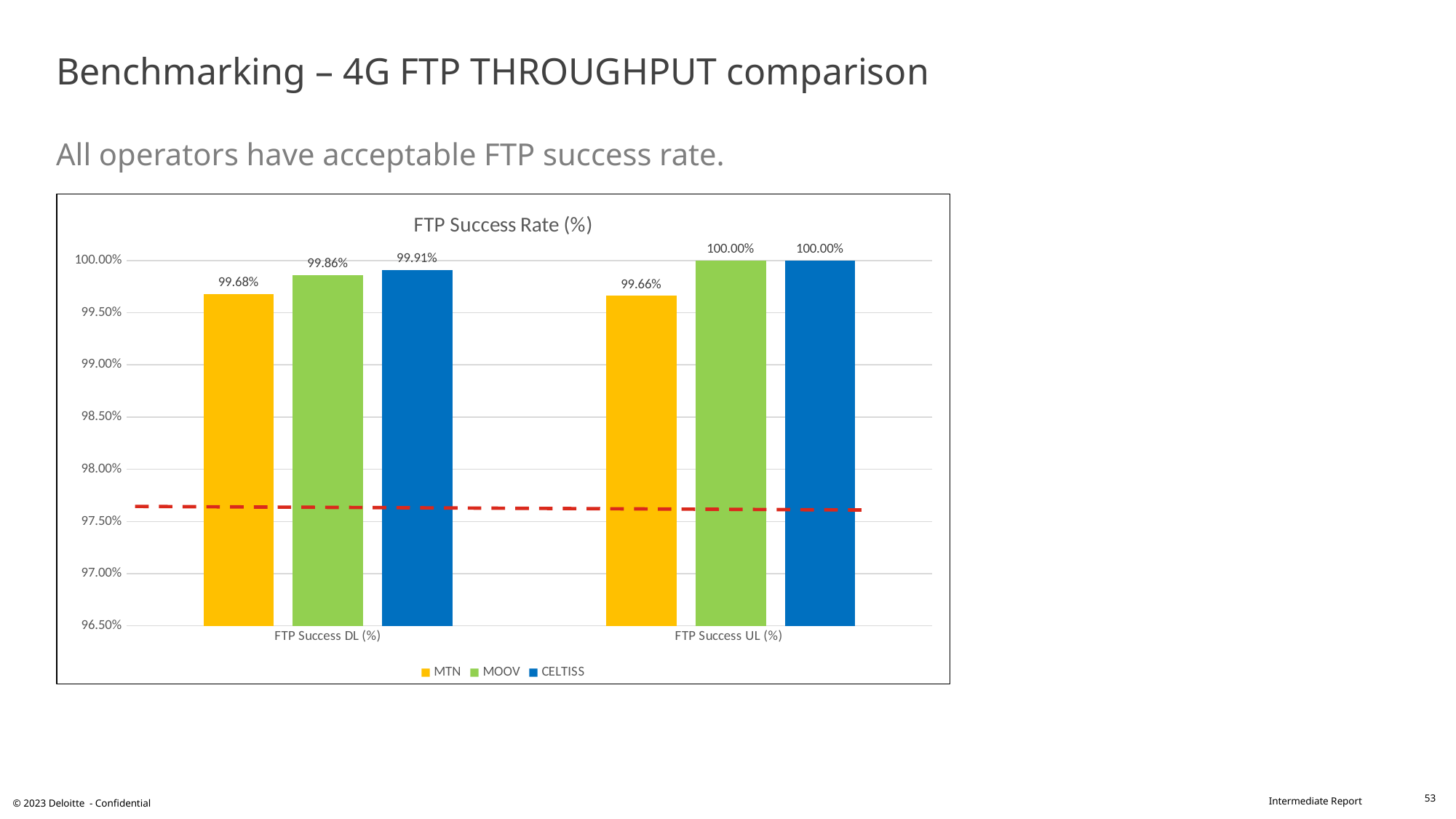
Which is larger: MOOV's FTP Success DL (%) or MTN's FTP Success DL (%)? MOOV's FTP Success DL (%) What is the FTP Success DL (%) value for MTN? 99.68% What is the FTP Success UL (%) value for MTN? 99.66% What is the FTP Success DL (%) value for CELTISS? 99.91% What is the title of the chart? FTP Success Rate (%) What is the difference between CELTISS and MTN for FTP Success DL (%)? 0.23% What is the FTP Success UL (%) value for MOOV? 100.00% What kind of chart is shown? Bar chart How many categories are shown on the x axis? 2 Which operator has the highest FTP Success DL (%)? CELTISS How many series does the legend list? 3 Which operator has the lowest FTP Success DL (%)? MTN